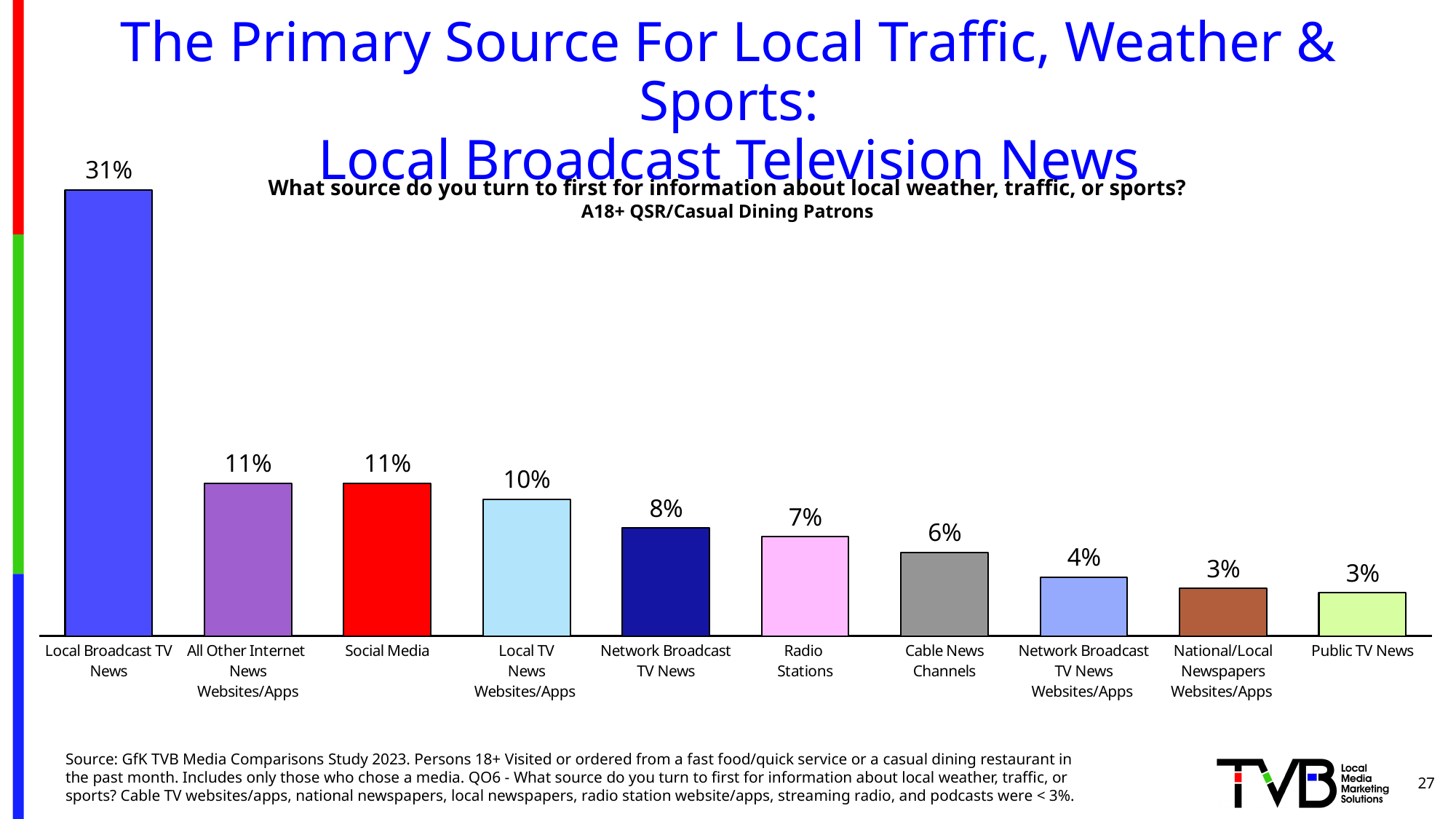
What colour is the bar for Social Media? Red Which is larger, the value for Radio Stations or the value for Cable News Channels? Radio Stations Which source has the highest value in the chart? Local Broadcast TV News What is the difference between the values for Local Broadcast TV News and Social Media? 20% What is the value shown for Cable News Channels? 6% What kind of chart is shown on the slide? Bar chart Do the values generally rise or fall moving from left to right across the chart? Fall What percentage of A18+ QSR/Casual Dining Patrons turn first to Local Broadcast TV News for local weather, traffic, or sports? 31% What is the value shown for Network Broadcast TV News Websites/Apps? 4% What is the value shown for Radio Stations? 7% How many sources (categories) are shown in the chart? 10 What is the difference between the values for Local TV News Websites/Apps and Network Broadcast TV News? 2%